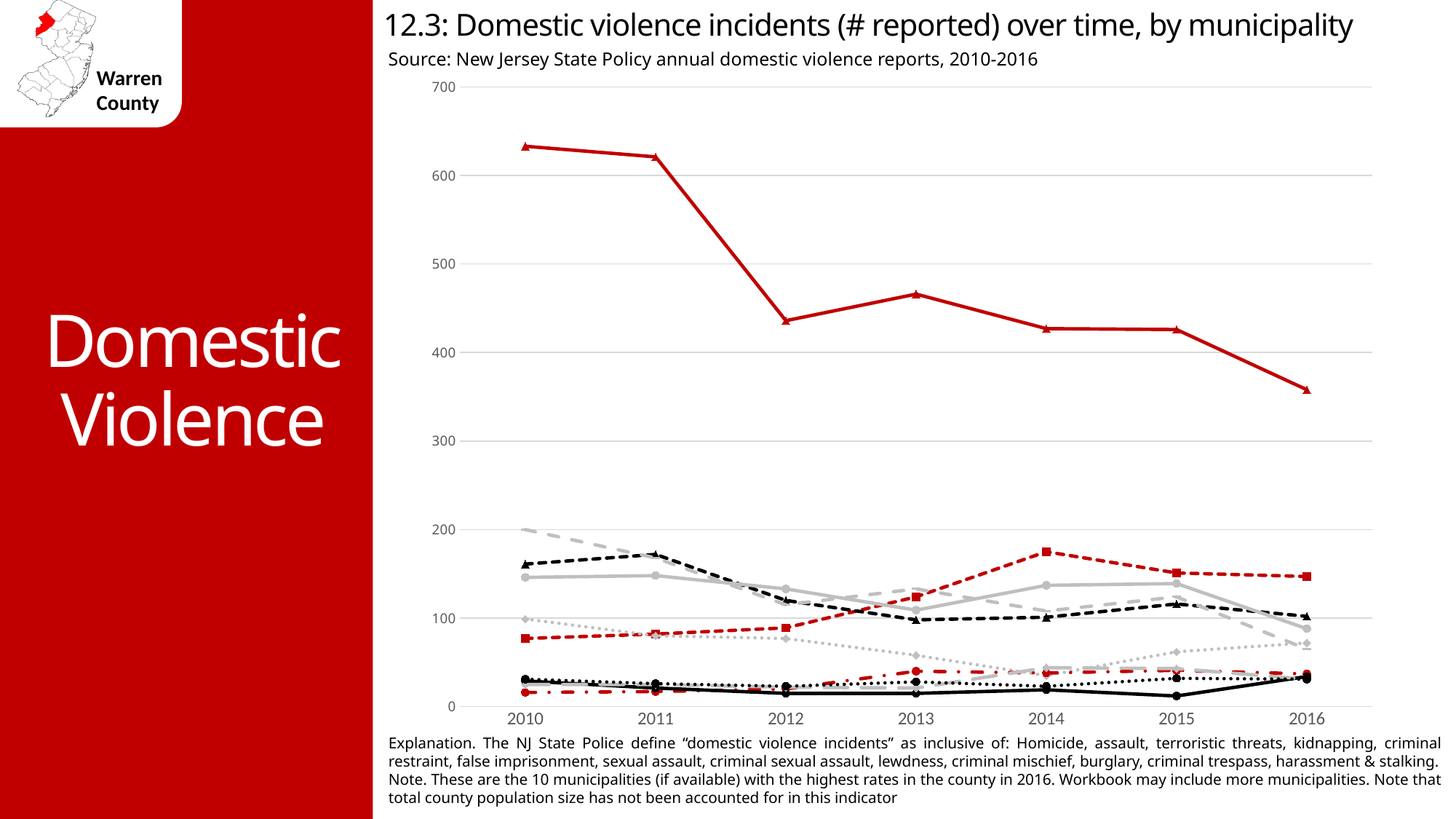
How many years are shown along the x axis of the chart? 7 In which year does the solid red line with triangle markers reach its lowest value? 2016 What is the last year shown on the x axis? 2016 What is the title of the chart? 12.3: Domestic violence incidents (# reported) over time, by municipality Does the solid red line with triangle markers (the highest line) rise or fall overall from 2010 to 2016? fall What is the highest value shown on the y axis of the chart? 700 Is the 2012 value of the solid red line with triangle markers greater or less than 500? less Is the 2013 value of the solid red line with triangle markers greater or less than 400? greater What is the first year shown on the x axis? 2010 Is the 2010 value of the solid red line with triangle markers greater or less than 600? greater What kind of chart is shown on the slide? line chart